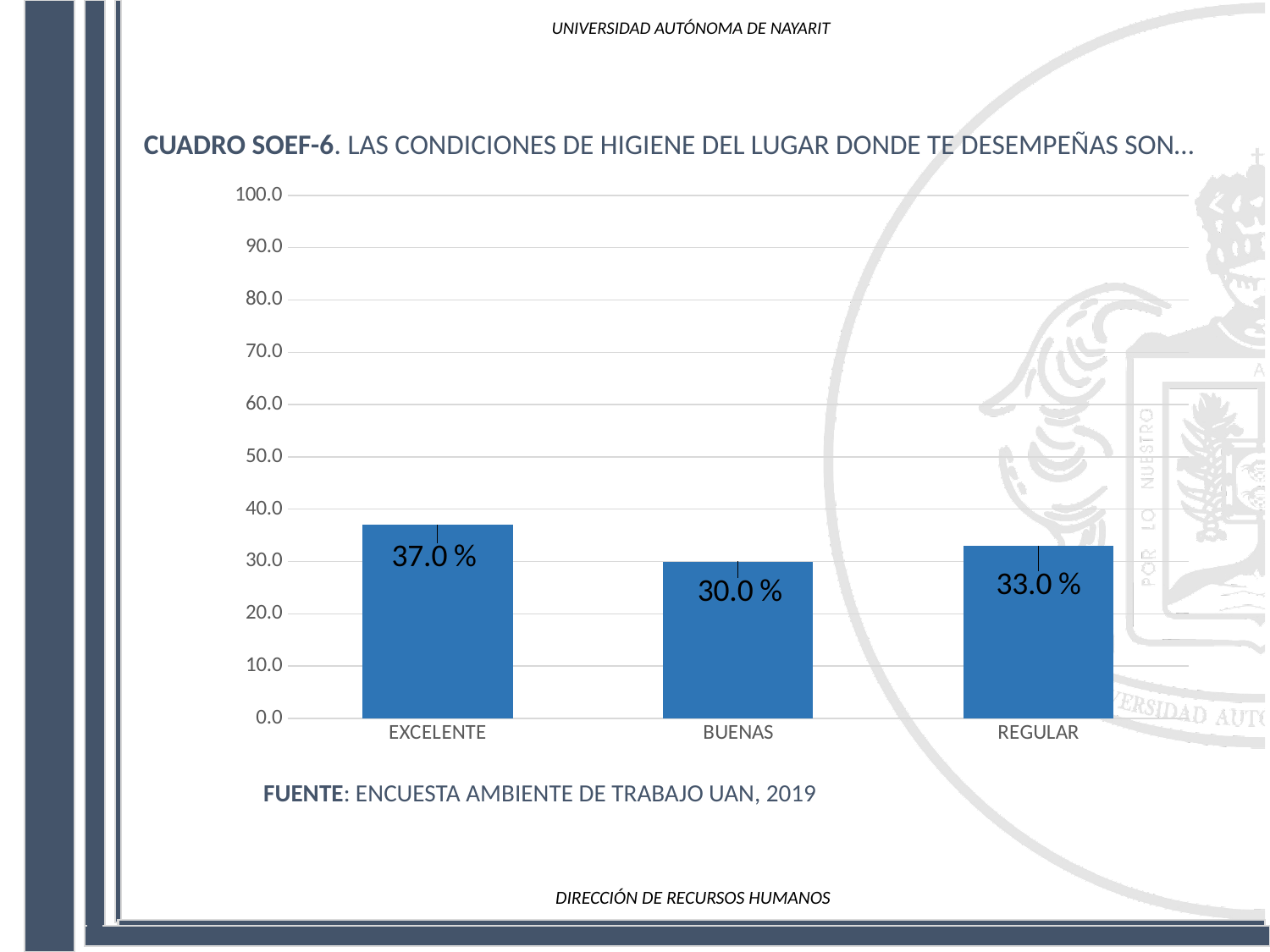
What kind of chart is shown on the slide? bar chart Which category has the lowest value? BUENAS Which category has the highest value? EXCELENTE What is the difference between the values for REGULAR and BUENAS? 3.0 % How many categories are shown on the x axis? 3 Which is larger, the value for EXCELENTE or the value for REGULAR? EXCELENTE What is the difference between the values for EXCELENTE and BUENAS? 7.0 % What is the value for BUENAS? 30.0 % Is the value for REGULAR greater or less than 40.0? less What is the value for REGULAR? 33.0 % What source is cited below the chart? ENCUESTA AMBIENTE DE TRABAJO UAN, 2019 What is the value for EXCELENTE? 37.0 %